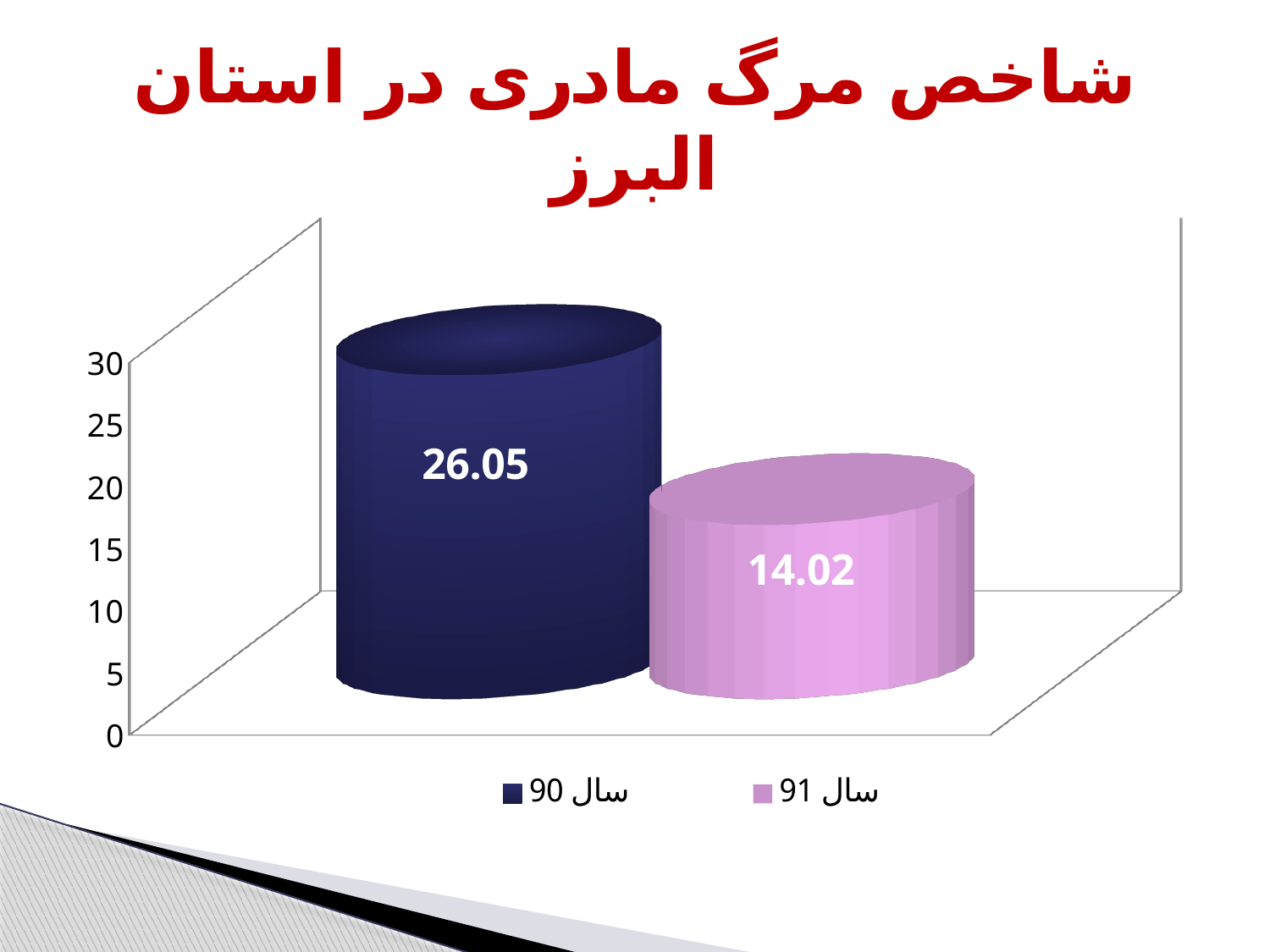
Is the value for سال 91 greater or less than 15? less What kind of chart is shown on the slide? bar chart Which series has the lowest value? سال 91 What is the value shown for سال 90? 26.05 What is the value shown for سال 91? 14.02 Which series has the highest value? سال 90 Which series has the higher value, سال 90 or سال 91? سال 90 How many series does the legend list? 2 What is the title of the chart on the slide? شاخص مرگ مادری در استان البرز What is the difference between the values for سال 90 and سال 91? 12.03 Is the value for سال 90 greater or less than 25? greater Does the value fall or rise from سال 90 to سال 91? fall